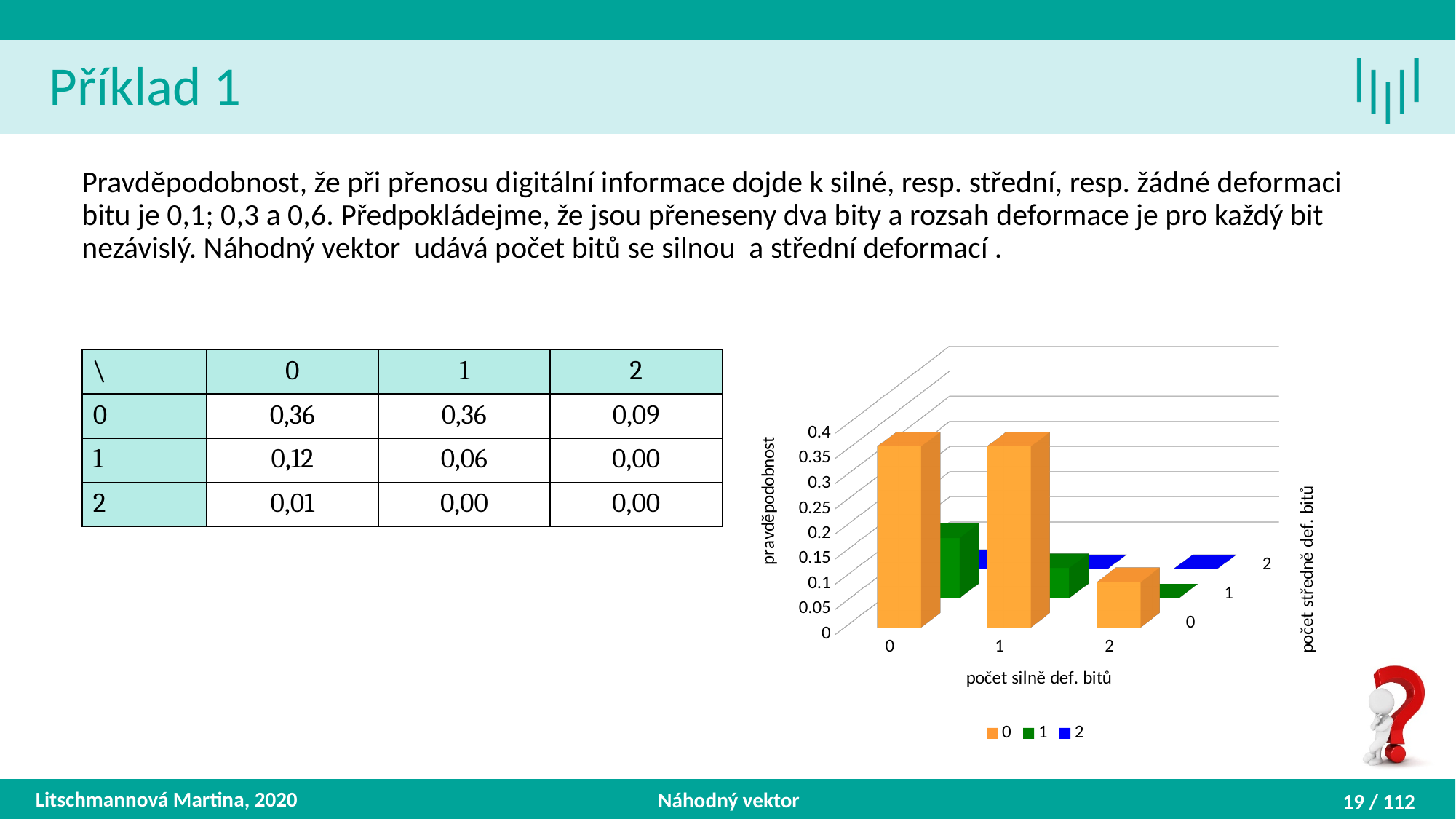
Do the values of series 1 rise or fall as x goes from 0 to 2? fall What kind of chart is shown on the slide? bar chart Is the value of series 1 at x = 0 greater or less than 0.2? less What is the title of the vertical axis of the chart? pravděpodobnost Is the value of series 0 at x = 2 greater or less than 0.15? less What is the title of the x axis of the chart? počet silně def. bitů How many categories are shown on the x axis (počet silně def. bitů) of the chart? 3 How many series does the chart legend list? 3 At x = 1, which is larger: the bar for series 0 or the bar for series 1? series 0 Is the value of series 0 at x = 0 greater or less than 0.2? greater Which series (legend entry) has the tallest bar in the chart? 0 Which series (legend entry) has the lowest bars in the chart? 2